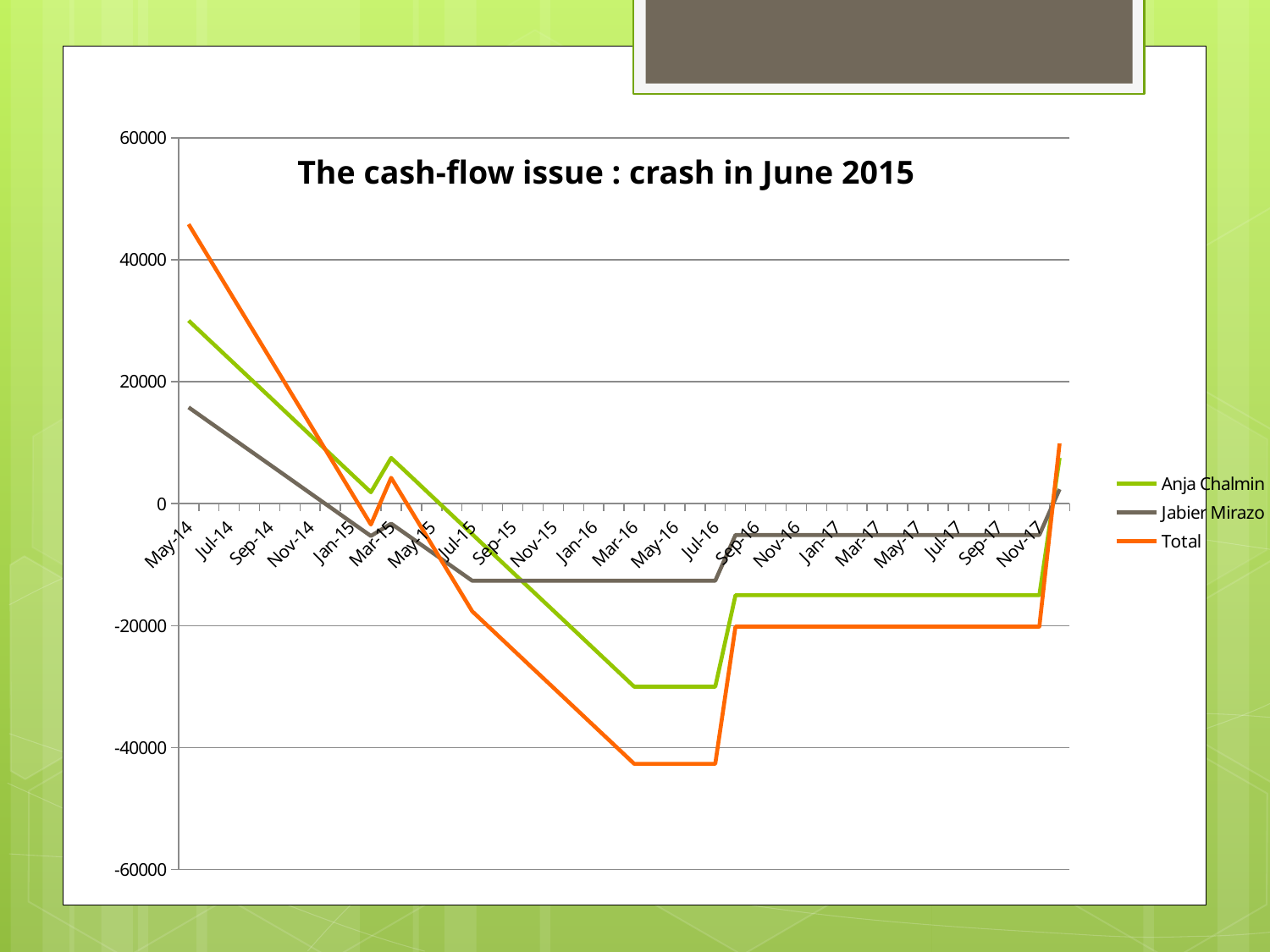
What kind of chart is shown on the slide? line chart Is the value for Anja Chalmin at May-16 greater or less than -20000? less Is the value for Jabier Mirazo at May-14 greater or less than 20000? less Which series is drawn in orange? Total How many series does the legend list? 3 Is the value for Total at May-16 greater or less than -40000? less Does the Total line rise or fall between May-14 and Jan-15? fall What is the title of the chart? The cash-flow issue : crash in June 2015 Which series has the lowest value at May-16? Total Which series has the highest value at May-14? Total